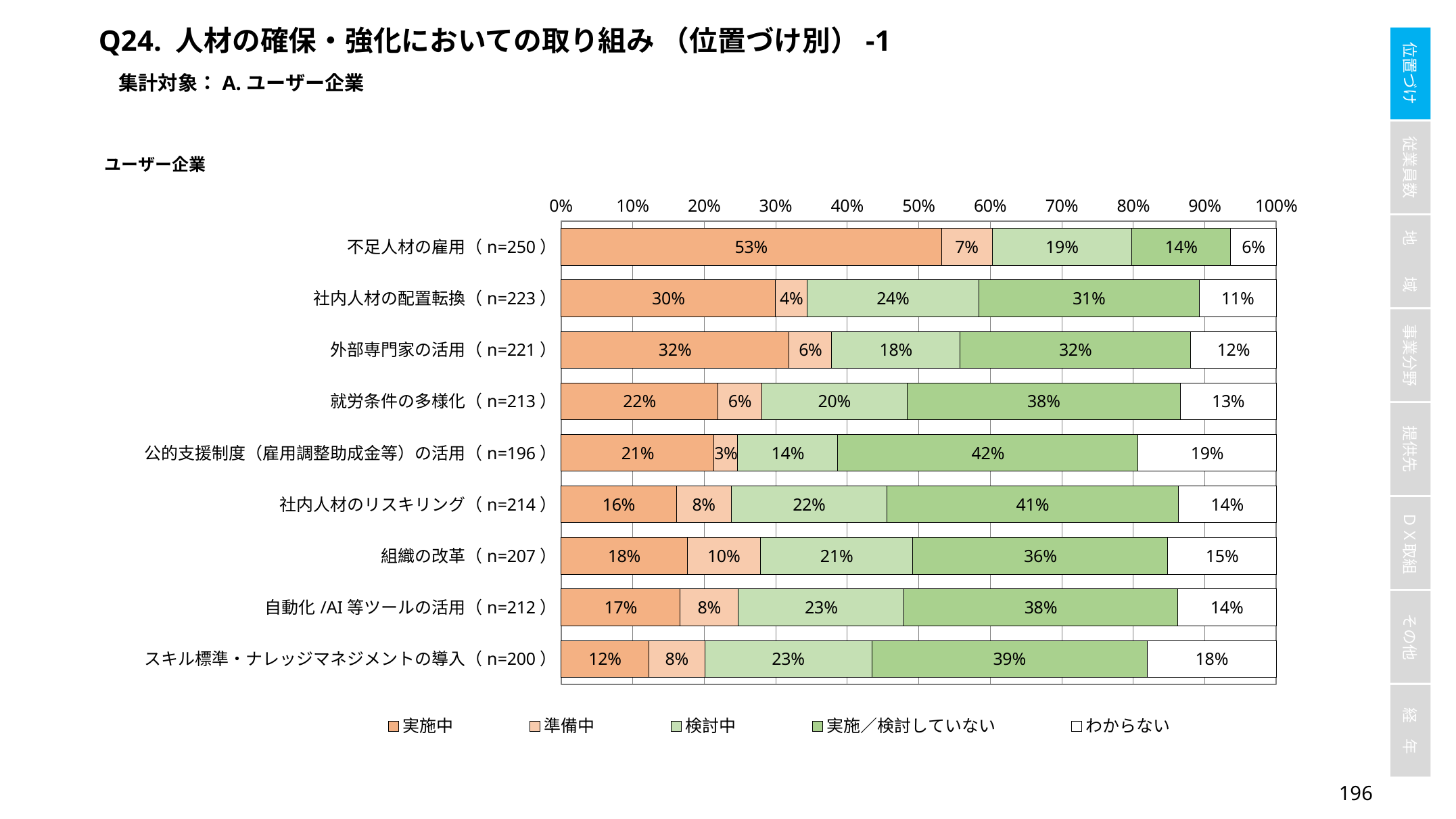
Which category has the highest 実施中 value? 不足人材の雇用 What is the 準備中 value for 組織の改革? 10% What is the わからない value for スキル標準・ナレッジマネジメントの導入? 18% How many categories (initiatives) are plotted on the chart? 9 What is the 実施／検討していない value for 公的支援制度（雇用調整助成金等）の活用? 42% What is the 実施中 value for 不足人材の雇用? 53% Which is larger: the 検討中 value for 社内人材の配置転換 or the 検討中 value for 外部専門家の活用? 社内人材の配置転換 Which category has the lowest 実施中 value? スキル標準・ナレッジマネジメントの導入 What type of chart is shown on the slide? Stacked bar chart How many series does the legend list? 5 What is the sample size (n) shown for 就労条件の多様化? n=213 What is the difference between the 実施中 values for 不足人材の雇用 and 社内人材の配置転換? 23%